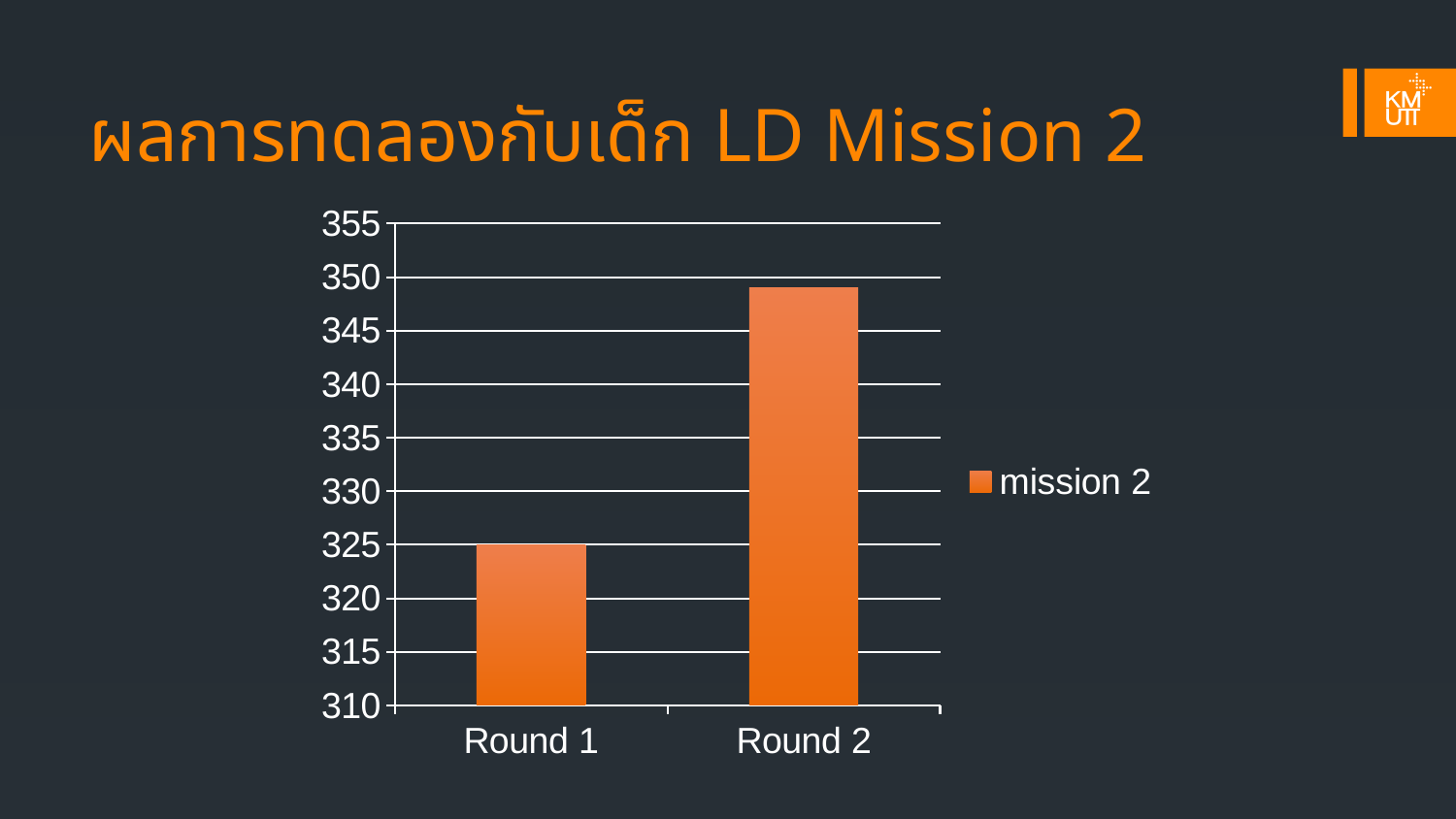
Which round has the lowest value in the chart? Round 1 Is the value for Round 2 greater or less than 345? greater How many categories are shown on the x axis of the chart? 2 Which round has the highest value in the chart? Round 2 What is the name of the series shown in the chart's legend? mission 2 What type of chart is shown on the slide? bar chart Is the value for Round 2 greater or less than 350? less Do the values rise or fall from Round 1 to Round 2 along the x axis? rise Is the value for Round 1 greater or less than 330? less Which is larger in the chart, the value for Round 1 or the value for Round 2? Round 2 What is the value for Round 1 in the chart? 325 How many series does the chart's legend list? 1